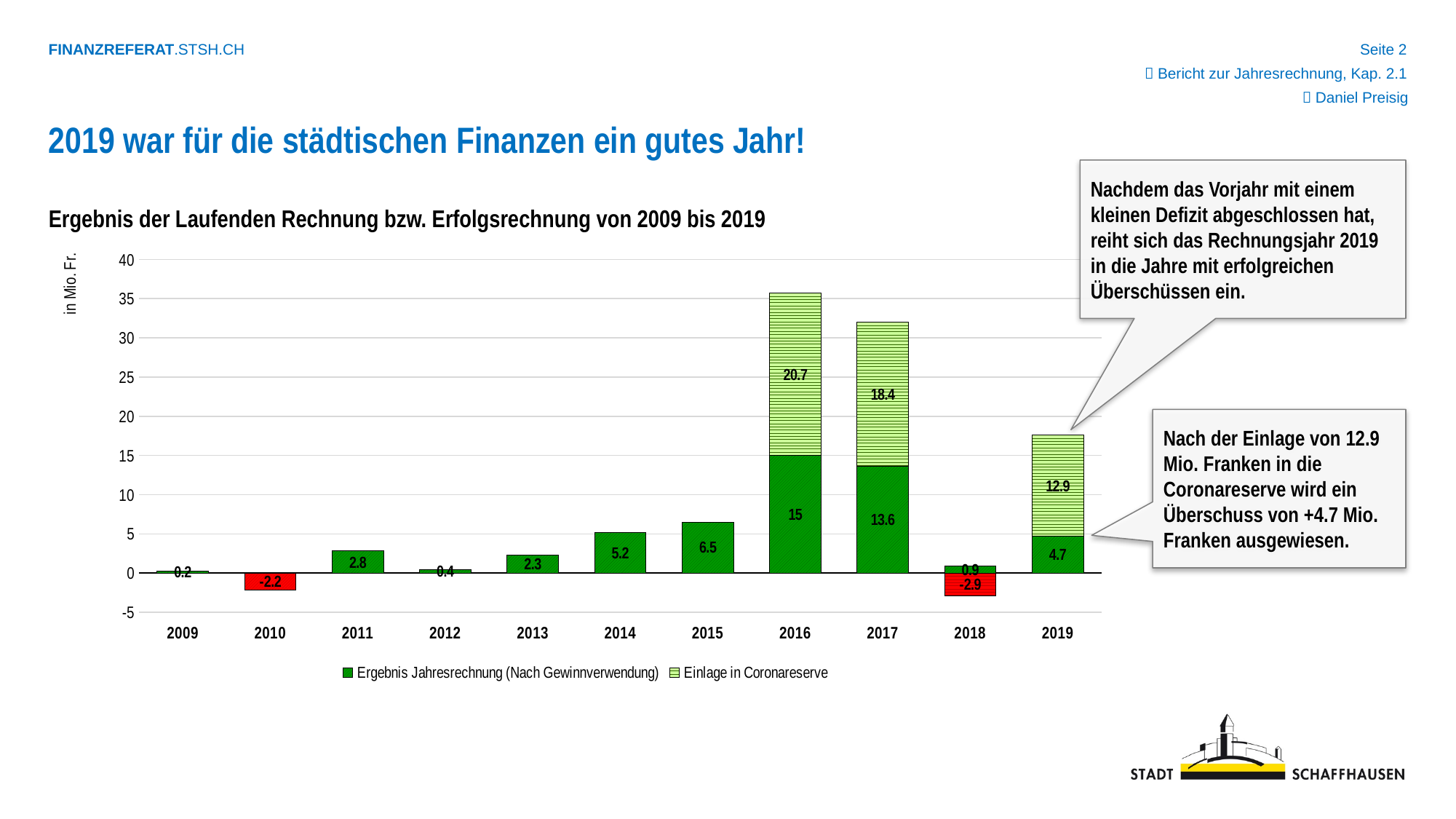
How many years are shown on the x axis? 11 What kind of chart is shown on the slide? bar chart What is the value of Ergebnis Jahresrechnung (Nach Gewinnverwendung) for 2015? 6.5 What is the total of the stacked bar for 2016? 35.7 What is the value of Einlage in Coronareserve for 2016? 20.7 What is the value of Einlage in Coronareserve for 2019? 12.9 How many series does the legend list? 2 What is the value of Ergebnis Jahresrechnung (Nach Gewinnverwendung) for 2017? 13.6 Is the total height of the stacked bar for 2017 greater or less than 30? greater Which year has the larger Ergebnis Jahresrechnung (Nach Gewinnverwendung) value, 2013 or 2014? 2014 Which year has the highest value for Ergebnis Jahresrechnung (Nach Gewinnverwendung)? 2016 What is the difference between the Einlage in Coronareserve values for 2016 and 2017? 2.3